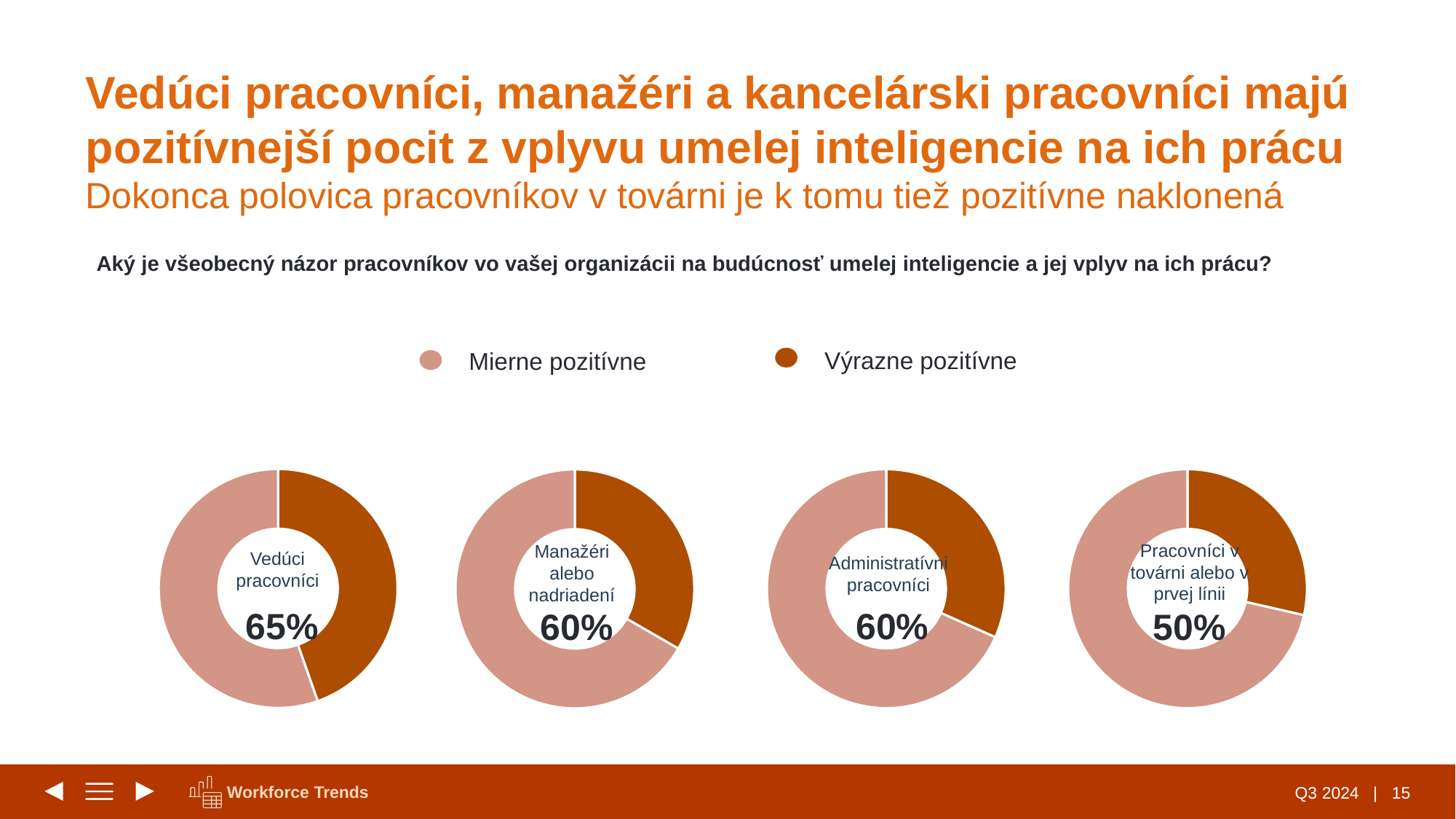
How many donut charts are shown on the slide? 4 Which worker group has the highest percentage shown in its donut chart? Vedúci pracovníci What is the difference between the percentage for Vedúci pracovníci and the percentage for Pracovníci v továrni alebo v prvej línii? 15 percentage points What percentage is shown in the centre of the donut chart for Administratívni pracovníci? 60% What type of chart is used to show the results for each worker group? Donut (pie) chart How many entries does the legend list? 2 What percentage is shown in the centre of the donut chart for Vedúci pracovníci? 65% Which has a higher percentage: Vedúci pracovníci or Manažéri alebo nadriadení? Vedúci pracovníci What percentage is shown in the centre of the donut chart for Pracovníci v továrni alebo v prvej línii? 50% Which worker group has the lowest percentage shown in its donut chart? Pracovníci v továrni alebo v prvej línii Which legend entry is shown in the darker orange colour? Výrazne pozitívne What percentage is shown in the centre of the donut chart for Manažéri alebo nadriadení? 60%